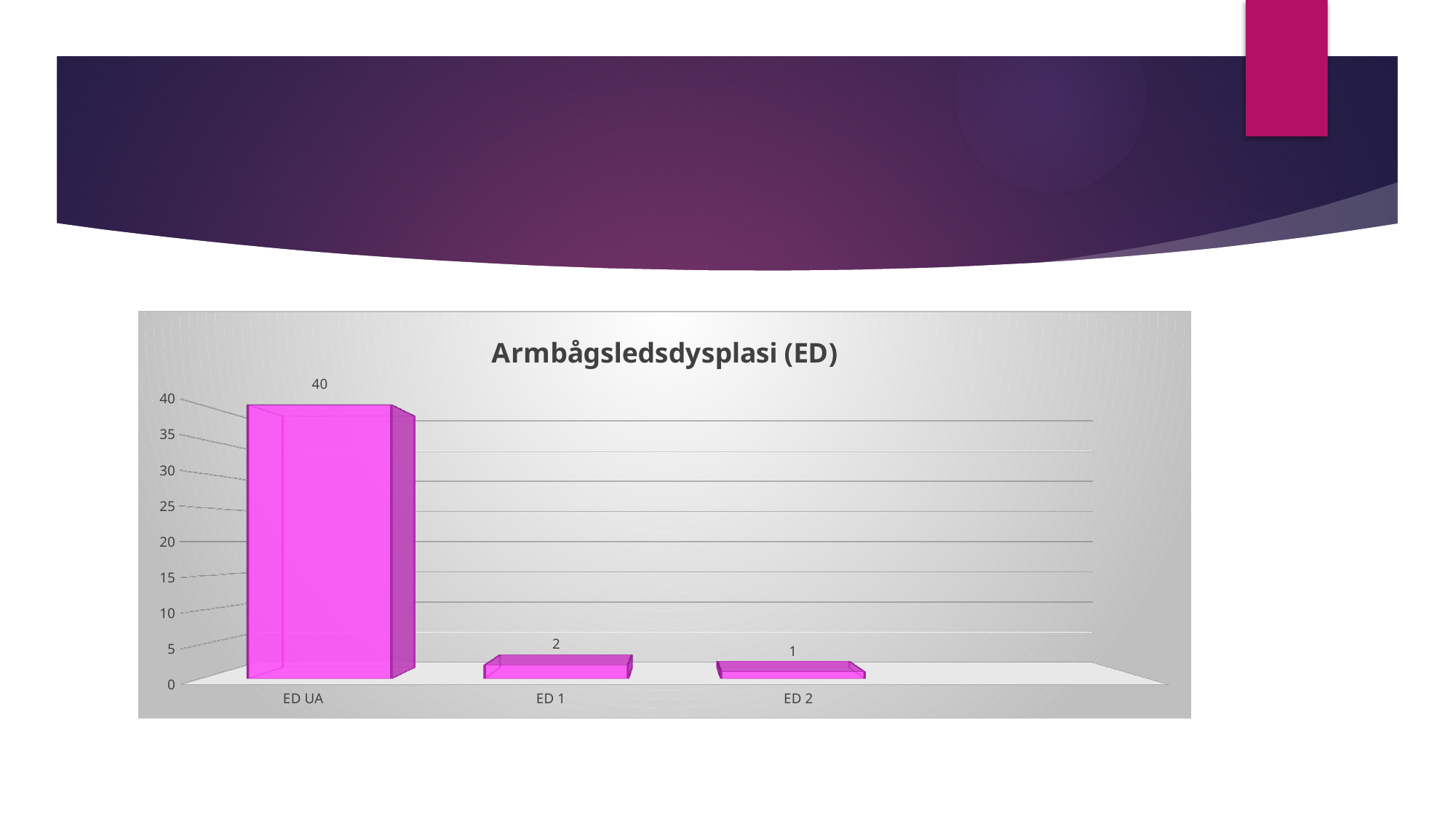
What is the difference between the values for ED UA and ED 1? 38 What kind of chart is shown on the slide? bar chart Is the value for ED UA greater or less than 35? greater What is the difference between the values for ED 1 and ED 2? 1 Which category has the lowest value? ED 2 How many categories are shown on the x axis? 3 Which category has the highest value? ED UA What is the title of the chart? Armbågsledsdysplasi (ED) What is the value for ED UA? 40 What is the value for ED 1? 2 Which is larger, the value for ED 1 or the value for ED 2? ED 1 What is the value for ED 2? 1